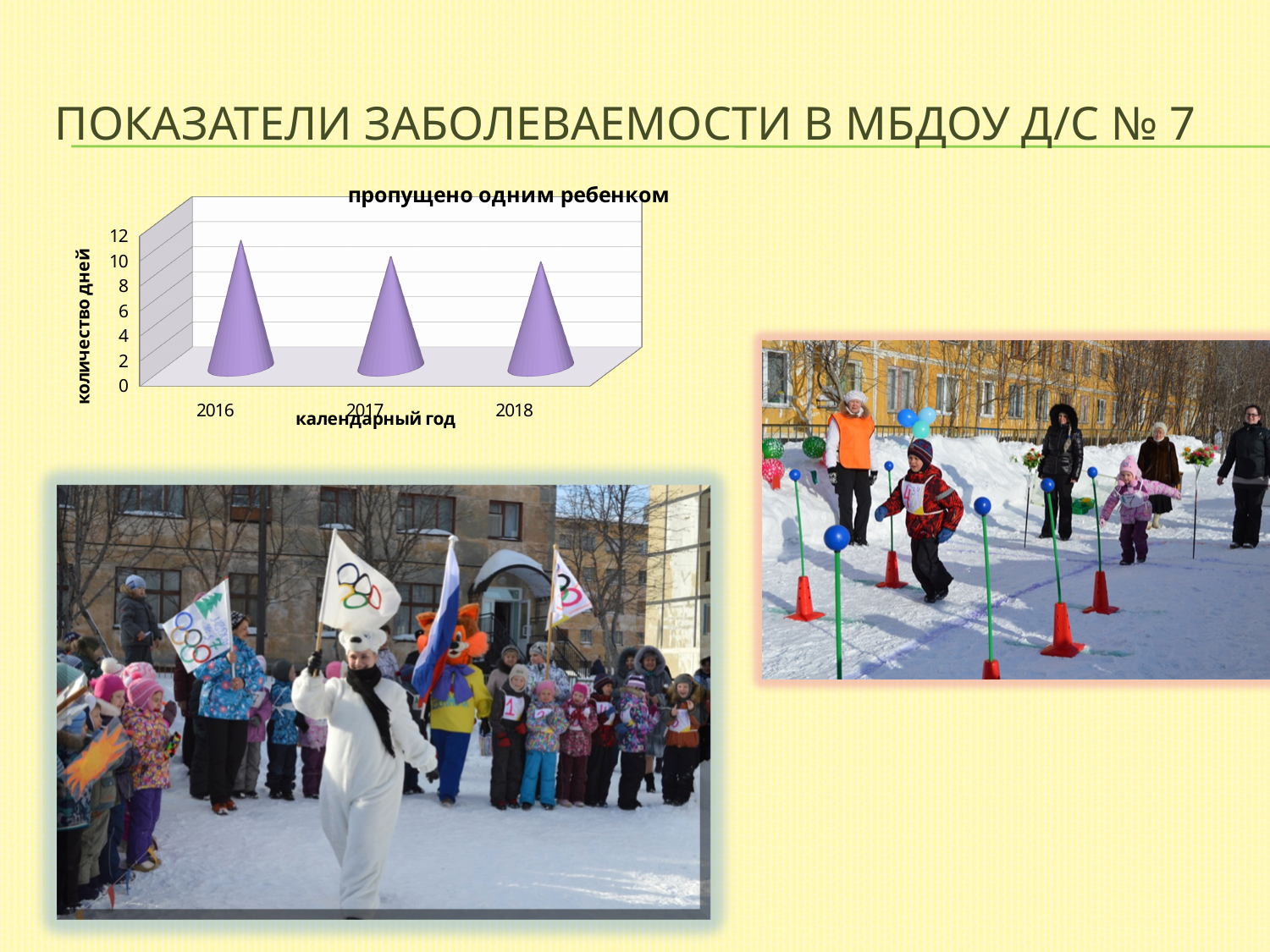
How many calendar years are shown on the x axis of the chart? 3 Do the values in the chart rise or fall from 2016 to 2018? fall What is the label of the vertical axis of the chart? количество дней Is the value for 2017 greater or less than 4? greater Which year has the highest value in the chart? 2016 Which is larger in the chart, the value for 2016 or the value for 2018? 2016 Is the value for 2018 greater or less than 12? less What kind of chart is shown on the slide? bar chart Is the value for 2016 greater or less than 6? greater What is the title of the chart on the slide? пропущено одним ребенком Which year has the lowest value in the chart? 2018